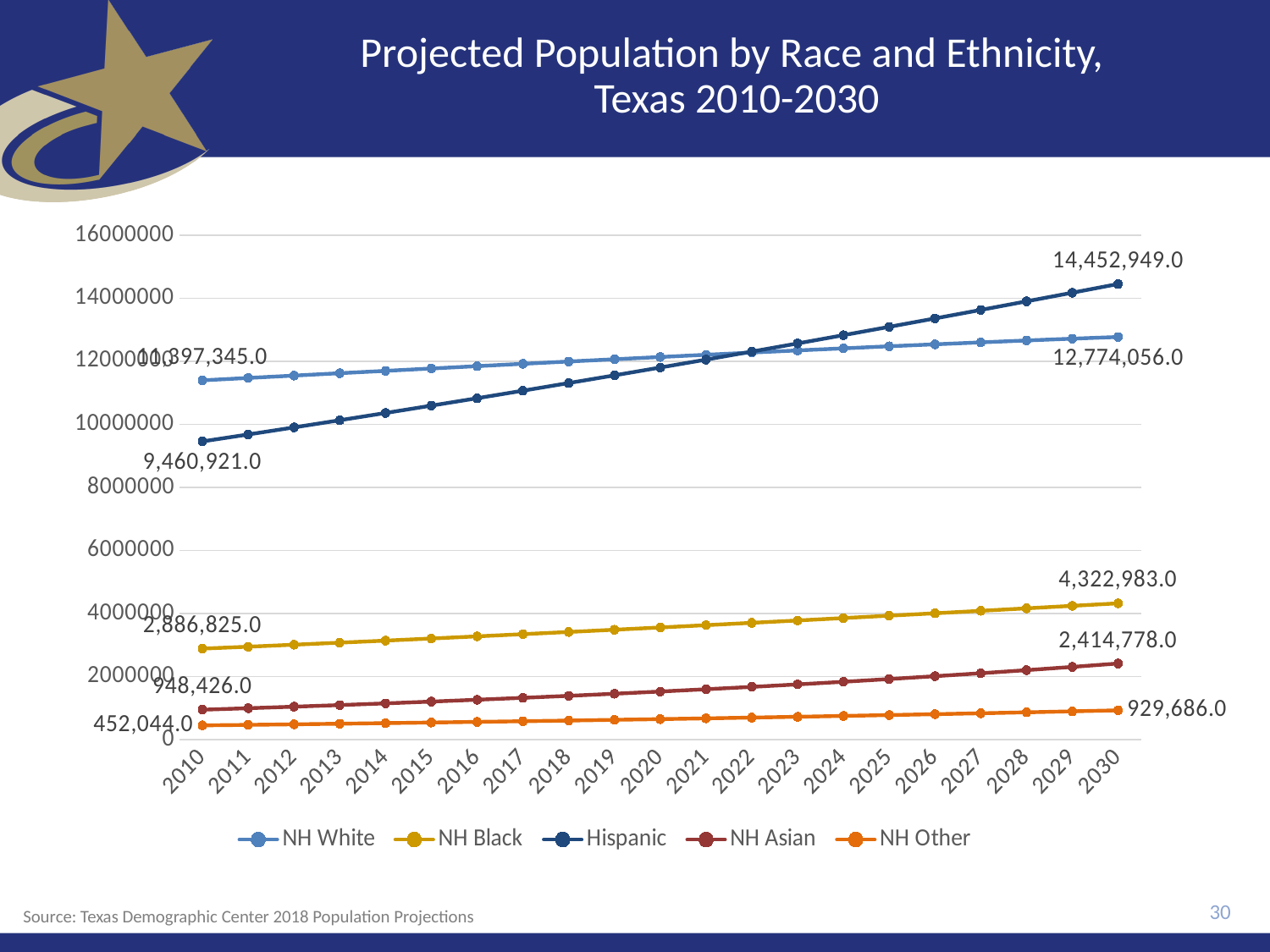
What type of chart is shown on the slide? line chart How many years are plotted along the x axis? 21 What is the projected NH Black population in 2030? 4,322,983.0 Which group has the lowest projected population in 2030? NH Other Is the projected Hispanic population in 2015 greater or less than 12000000? less Which group has the highest projected population in 2030? Hispanic What is the projected Hispanic population in 2010? 9,460,921.0 By how much does the projected Hispanic population increase from 2010 to 2030? 4,992,028.0 In 2030, which is larger: the NH White population or the Hispanic population? Hispanic What is the projected Hispanic population in 2030? 14,452,949.0 How many series does the legend list? 5 What is the projected NH Other population in 2010? 452,044.0